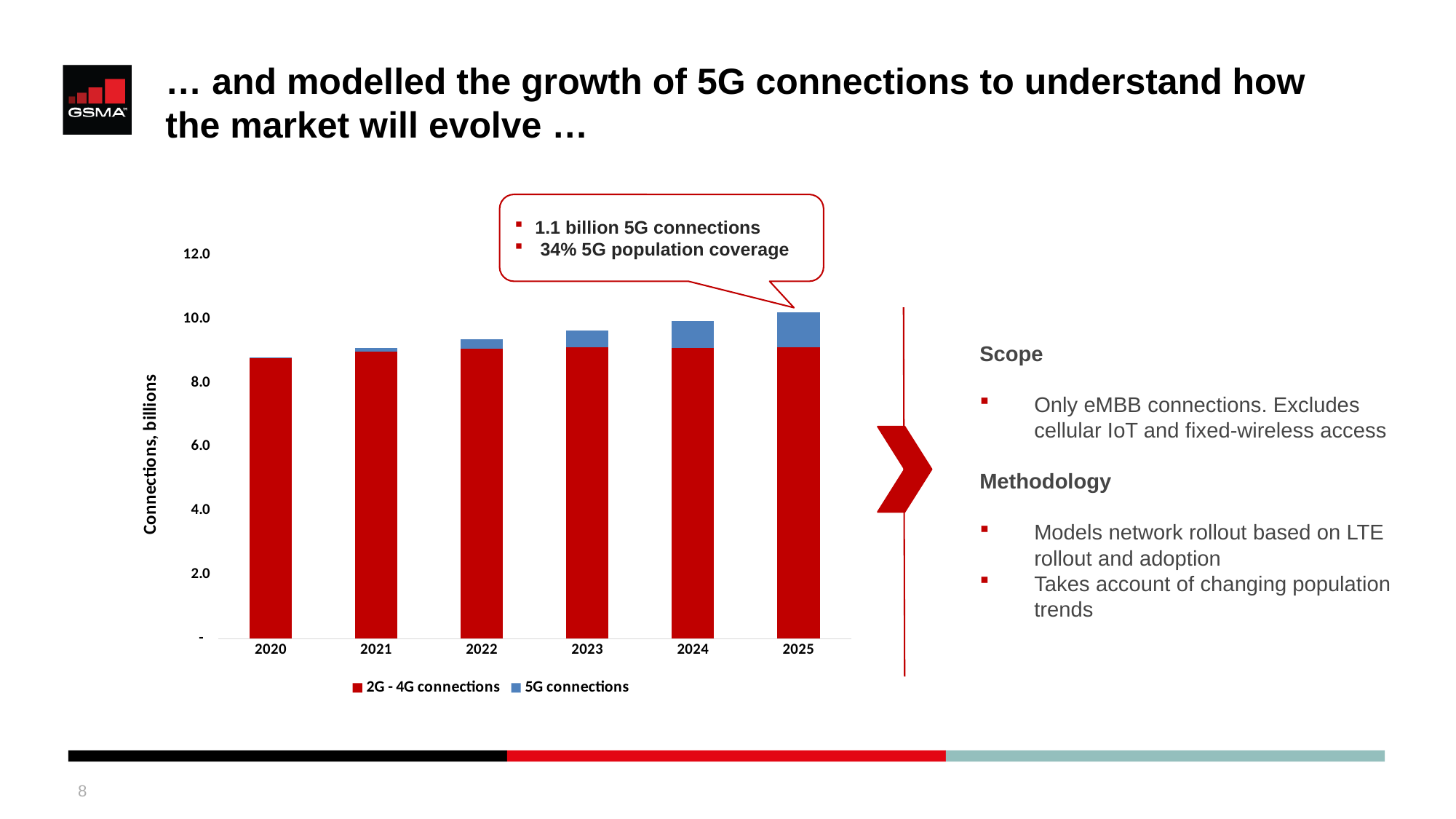
How many series does the chart legend list? 2 Is the total connections value for 2022 greater or less than 8.0 billion? greater What are the two series listed in the chart legend? 2G - 4G connections and 5G connections According to the callout on the chart, how many 5G connections are there in 2025? 1.1 billion In which year is the 5G connections segment the largest? 2025 Is the total connections value for 2020 greater or less than 10.0 billion? less According to the callout on the chart, what is the 5G population coverage in 2025? 34% What kind of chart is shown on the slide? Stacked bar chart How many years are shown on the x axis of the chart? 6 In which year is the total stacked bar the lowest? 2020 Do 5G connections rise or fall from 2020 to 2025? Rise What is the label of the vertical axis of the chart? Connections, billions